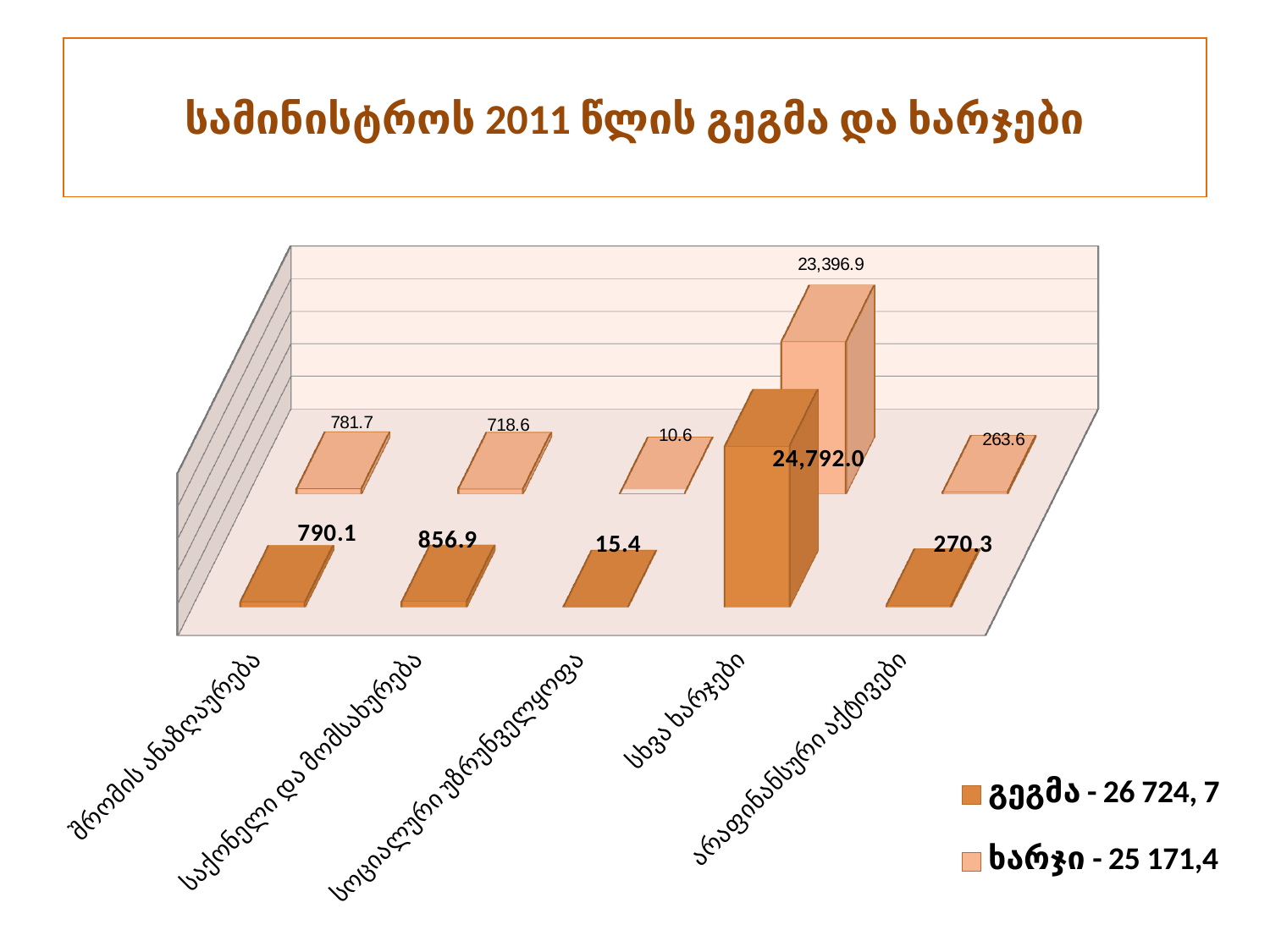
What is the difference between the გეგმა and ხარჯი values for სოციალური უზრუნველყოფა? 4.8 Which category has the lowest გეგმა value? სოციალური უზრუნველყოფა What is the ხარჯი value for საქონელი და მომსახურება? 718.6 What is the გეგმა value for სხვა ხარჯები? 24,792.0 What is the ხარჯი value for არაფინანსური აქტივები? 263.6 What is the გეგმა value for შრომის ანაზღაურება? 790.1 How many categories are shown on the x axis? 5 What kind of chart is shown on the slide? bar chart Which category has the highest ხარჯი value? სხვა ხარჯები What total is shown next to გეგმა in the legend? 26 724, 7 Which is larger for საქონელი და მომსახურება: the გეგმა value or the ხარჯი value? გეგმა How many series does the legend list? 2